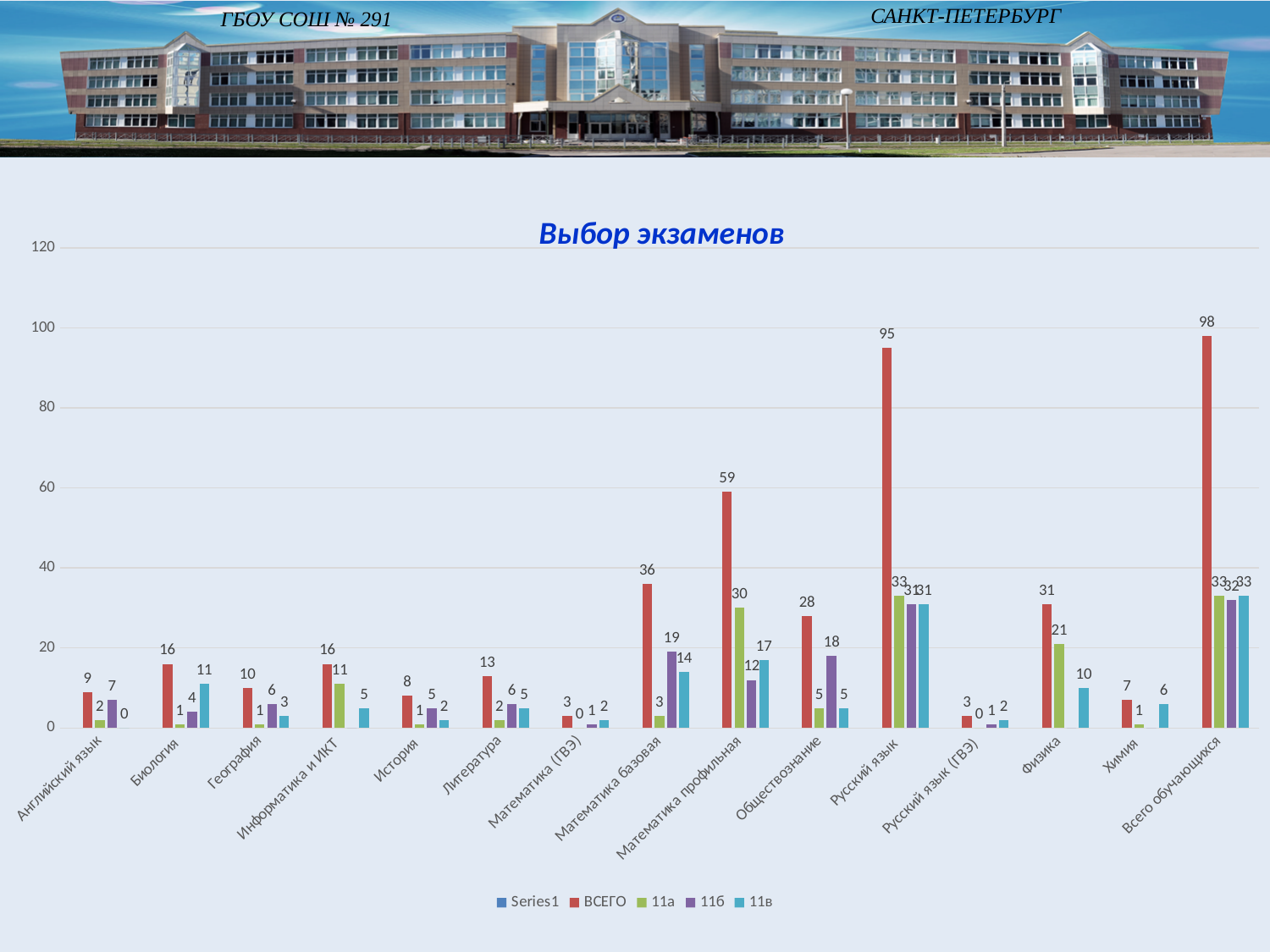
What is the difference between the ВСЕГО values for Математика профильная and Математика базовая? 23 What is the title of the chart? Выбор экзаменов Which is larger: the 11в value for Биология or the 11в value for Физика? Биология What is the 11б value for Обществознание? 18 What type of chart is shown on the slide? bar chart Which category has the highest ВСЕГО value? Всего обучающихся How many series does the legend list? 5 What is the 11а value for Математика профильная? 30 What is the ВСЕГО value for Русский язык? 95 What is the 11в value for Английский язык? 0 How many categories are shown on the x axis? 15 Is the ВСЕГО value for Физика greater or less than 40? less